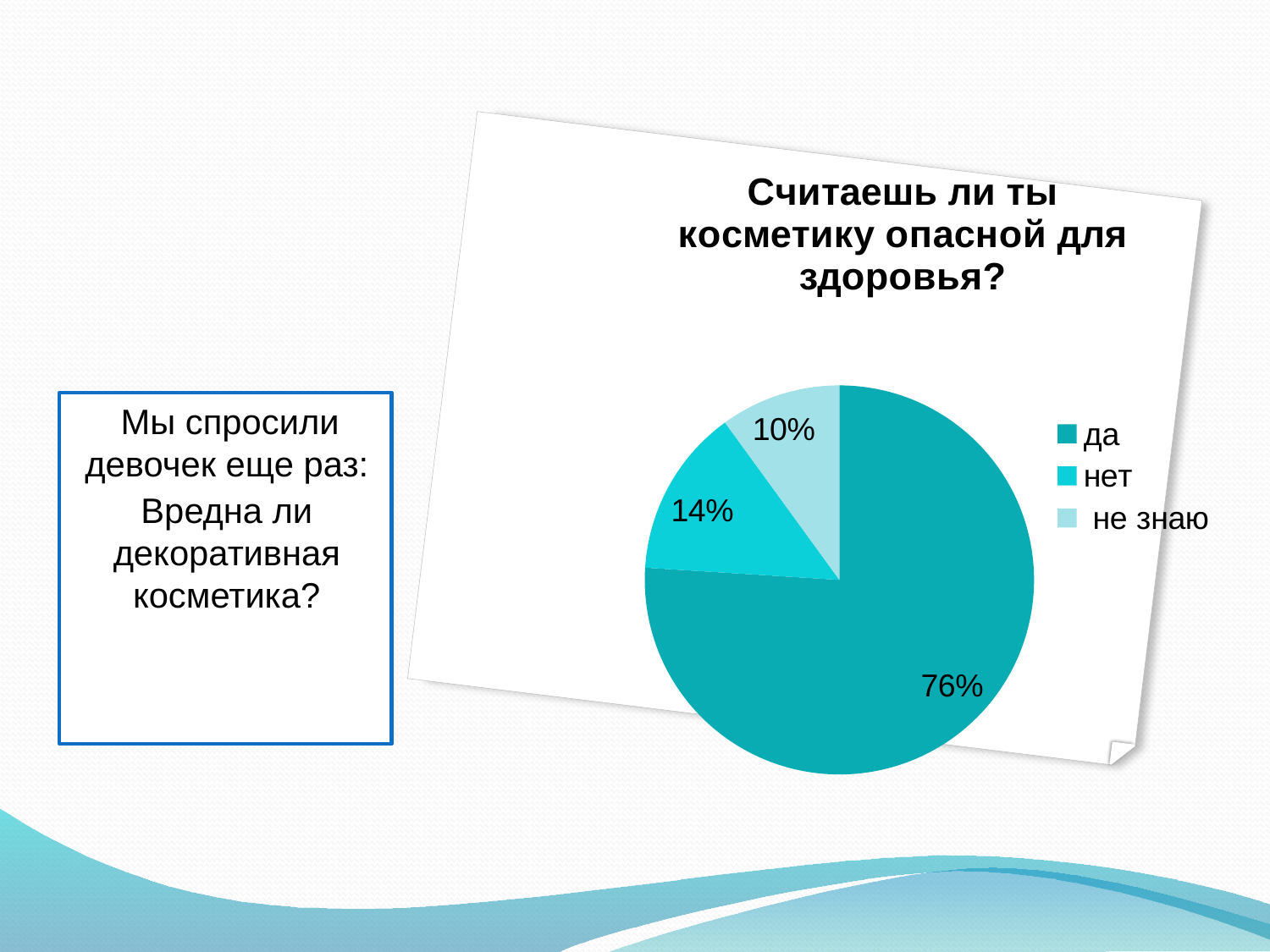
How many entries does the legend list? 3 What is the title of the chart? Считаешь ли ты косметику опасной для здоровья? What kind of chart is shown on the slide? pie chart What is the difference in percentage points between "нет" and "не знаю"? 4 How many slices does the pie chart have? 3 Which is larger, the slice for "нет" or the slice for "не знаю"? нет Which category has the smallest slice of the pie? не знаю What is the difference in percentage points between "да" and "нет"? 62 What percentage of the pie corresponds to "нет"? 14% What percentage of the pie corresponds to "не знаю"? 10% What percentage of the pie corresponds to "да"? 76% Which category has the largest slice of the pie? да